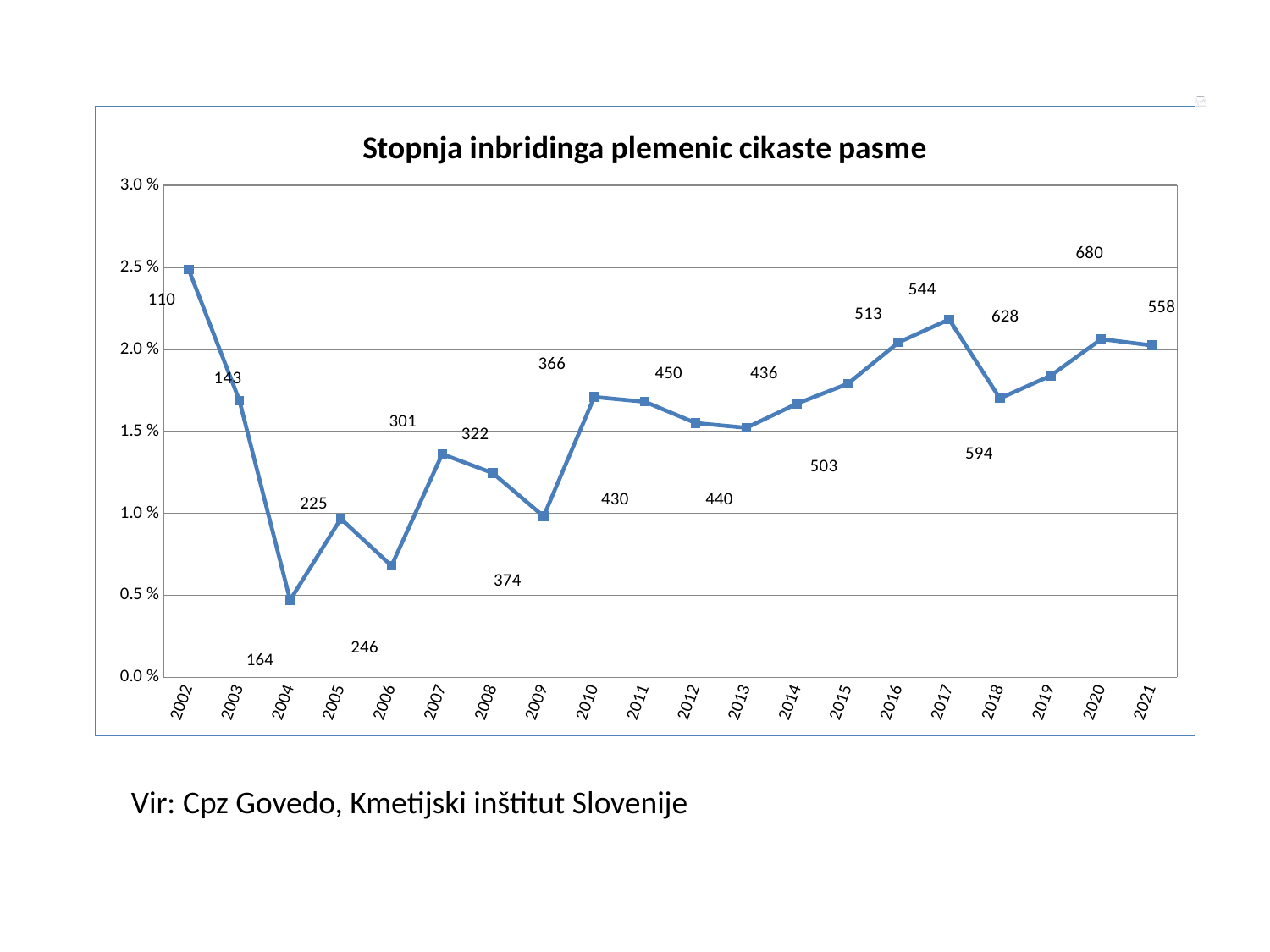
Is the plotted value for 2002 greater or less than 2.0 %? greater Is the plotted value for 2007 greater or less than 1.5 %? less In which year is the plotted inbreeding rate highest? 2002 Is the plotted value for 2006 greater or less than 1.0 %? less What is the title of the chart? Stopnja inbridinga plemenic cikaste pasme What kind of chart is shown on the slide? line chart Does the plotted value rise or fall from 2002 to 2004? fall Does the plotted value rise or fall from 2013 to 2017? rise How many years are plotted along the x axis of the chart? 20 In which year is the plotted inbreeding rate lowest? 2004